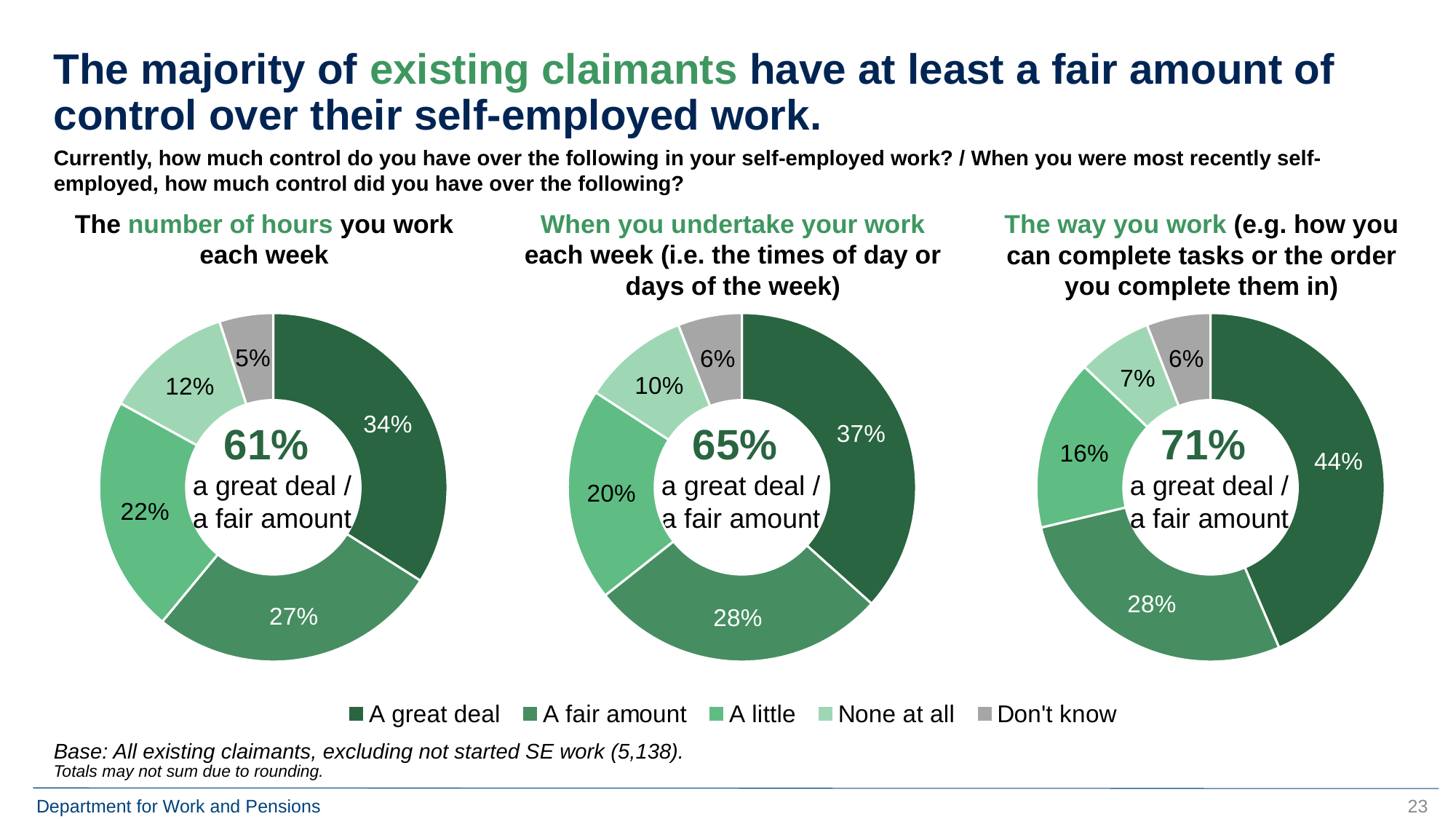
In the chart titled 'When you undertake your work each week', what is the difference between the 'A great deal' and 'A little' shares? 17% In the chart titled 'The way you work', which is larger: the 'None at all' share or the 'Don't know' share? None at all In the chart titled 'The number of hours you work each week', what combined percentage is shown in the centre for 'a great deal / a fair amount'? 61% How many doughnut charts are shown on the slide? 3 In the chart titled 'The way you work', what percentage answered 'A little'? 16% In the chart titled 'The number of hours you work each week', what percentage answered 'A great deal'? 34% In the chart titled 'When you undertake your work each week', what percentage answered 'A fair amount'? 28% How many response categories does the legend list? 5 In the chart titled 'The way you work', which response category has the largest share? A great deal In the chart titled 'The way you work', what combined percentage is shown in the centre for 'a great deal / a fair amount'? 71% In the chart titled 'The number of hours you work each week', which response category has the smallest share? Don't know What type of chart is used on this slide? Doughnut chart